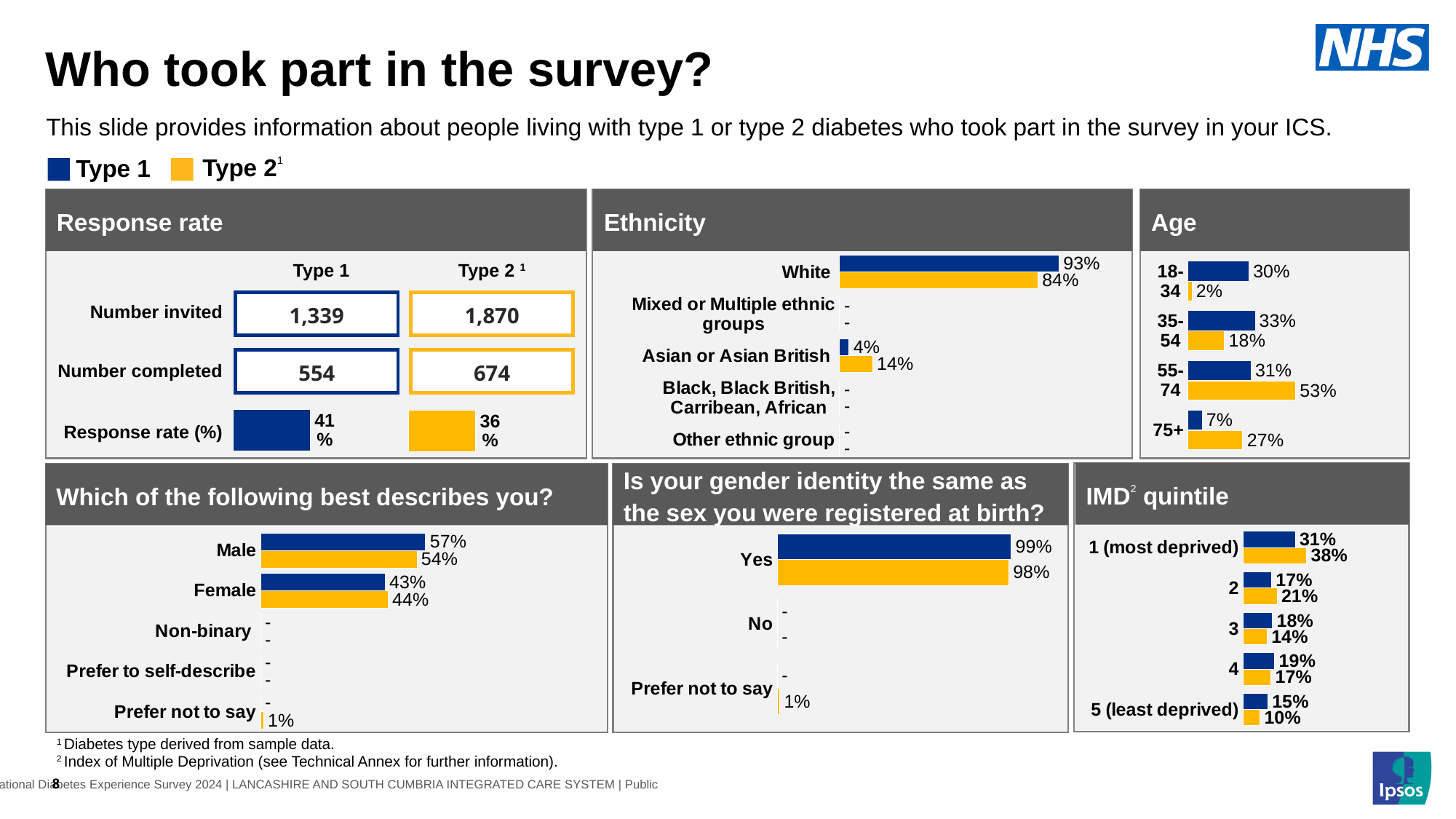
In the Age chart, which age group has the highest Type 2 value? 55-74 In the IMD quintile chart, which quintile has the highest Type 2 value? 1 (most deprived) In the Age chart, what is the difference between the Type 1 and Type 2 values for 75+? 20% How many series does the legend at the top of the slide list? 2 In the 'Which of the following best describes you?' chart, is the Type 2 value for Female larger or smaller than the Type 1 value for Female? larger In the IMD quintile chart, what is the difference between the Type 1 and Type 2 values for quintile 5 (least deprived)? 5% In the Ethnicity chart, what is the Type 2 value for Asian or Asian British? 14% In the gender identity chart, what is the Type 2 value for Yes? 98% In the Ethnicity chart, what is the Type 1 value for White? 93% In the Response rate panel, what is the number completed for Type 2? 674 In the 'Which of the following best describes you?' chart, what is the Type 1 value for Male? 57% In the Age chart, which age group has the lowest Type 1 value? 75+